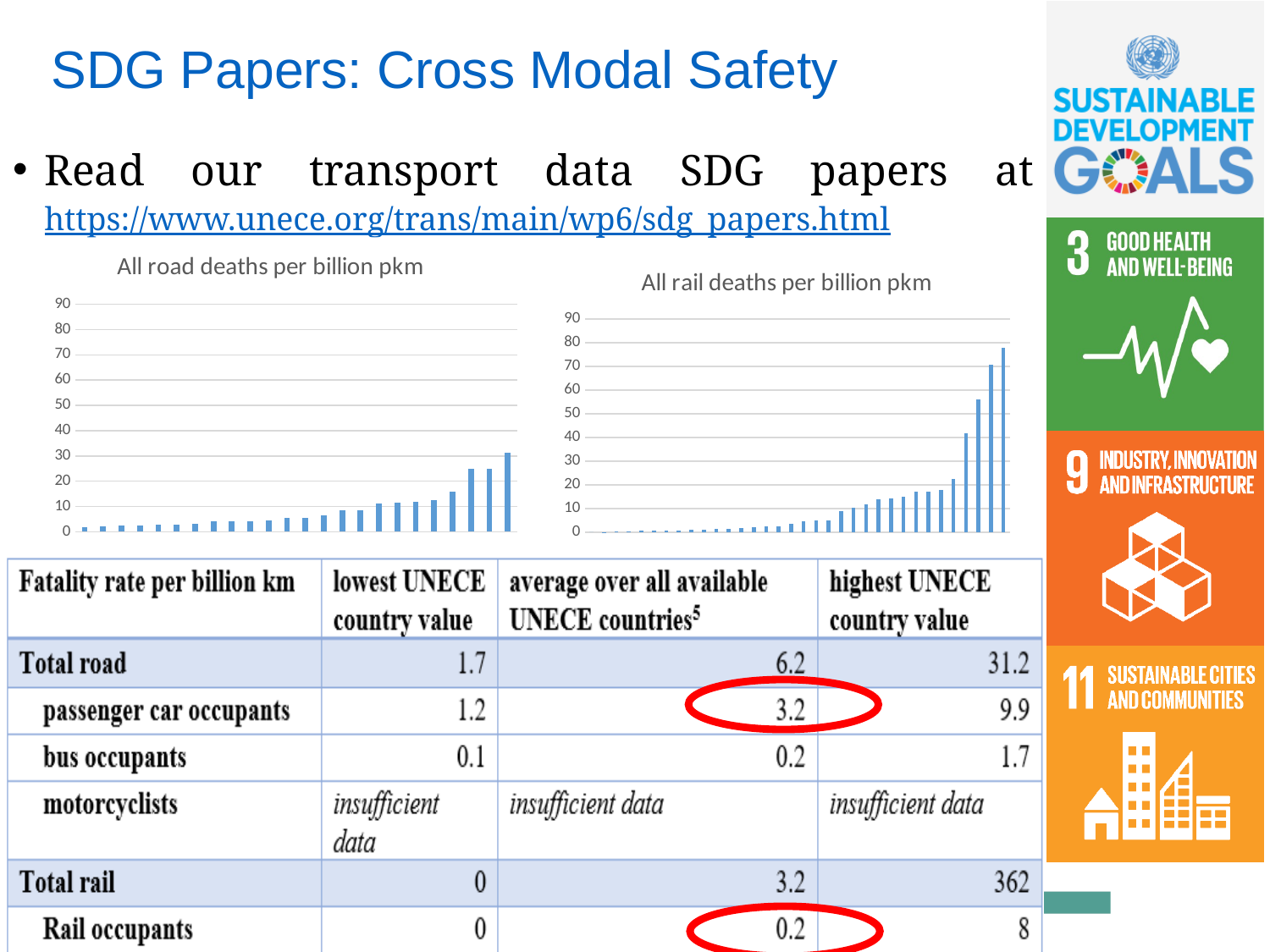
What is the title of the chart on the left? All road deaths per billion pkm What is the title of the chart on the right? All rail deaths per billion pkm In the 'All road deaths per billion pkm' chart, do the bar values rise or fall from left to right? rise In the 'All road deaths per billion pkm' chart, is the value of the tallest bar greater or less than 40? less What kind of chart is the 'All road deaths per billion pkm' chart? bar chart In the 'All rail deaths per billion pkm' chart, do the bar values rise or fall from left to right? rise In the 'All rail deaths per billion pkm' chart, is the value of the tallest bar greater or less than 70? greater Which chart has the taller maximum bar, 'All road deaths per billion pkm' or 'All rail deaths per billion pkm'? All rail deaths per billion pkm In the 'All road deaths per billion pkm' chart, is the value of the tallest bar greater or less than 20? greater What kind of chart is the 'All rail deaths per billion pkm' chart? bar chart In the 'All rail deaths per billion pkm' chart, what is the highest value shown on the vertical axis? 90